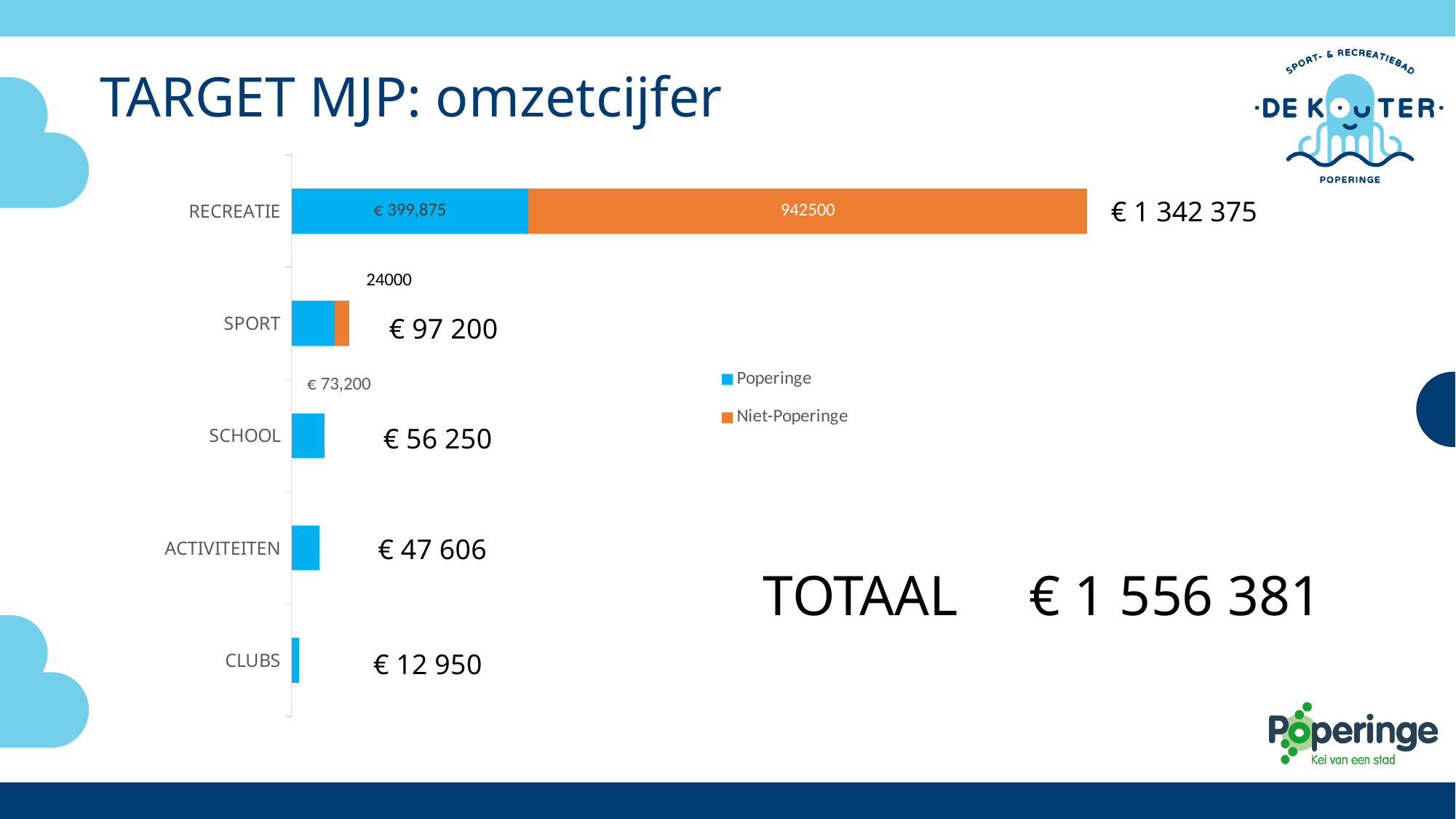
Which category has the shortest bar? CLUBS What is the Poperinge value labelled for SCHOOL? € 56 250 What is the Niet-Poperinge value for RECREATIE? 942500 What is the Poperinge value for RECREATIE? € 399,875 Which category has the longest bar? RECREATIE What is the Niet-Poperinge value labelled for SPORT? 24000 How many categories are shown on the vertical axis of the chart? 5 How many series does the legend list? 2 What kind of chart is shown on the slide? bar chart What total is printed next to the RECREATIE bar? € 1 342 375 For RECREATIE, which is larger: the Poperinge value or the Niet-Poperinge value? Niet-Poperinge Which colour represents the Niet-Poperinge series? orange